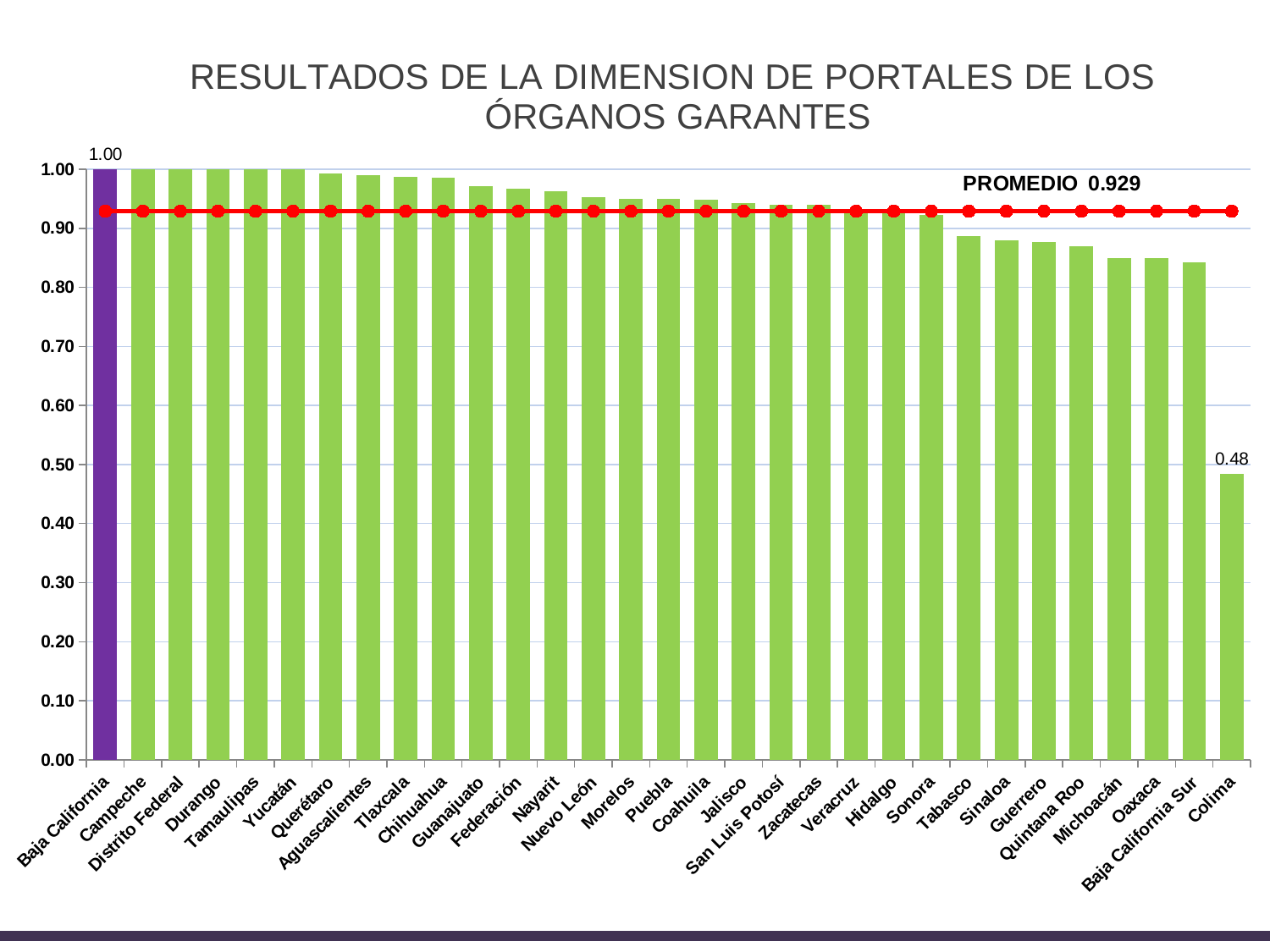
Which category has the lowest value? Colima Do the bar values rise or fall from left to right along the x axis? Fall What is the PROMEDIO (average) value shown by the red line? 0.929 How many categories are shown on the x axis? 31 Which has the larger value, Tabasco or Colima? Tabasco Is the value for Baja California Sur greater or less than 0.80? greater What is the value for Colima? 0.48 Is the value for Tabasco greater or less than 0.90? less What is the difference between the values for Baja California and Colima? 0.52 Is the value for Colima greater or less than 0.50? less What is the value for Baja California? 1.00 What kind of chart is shown on the slide? Combination bar and line chart